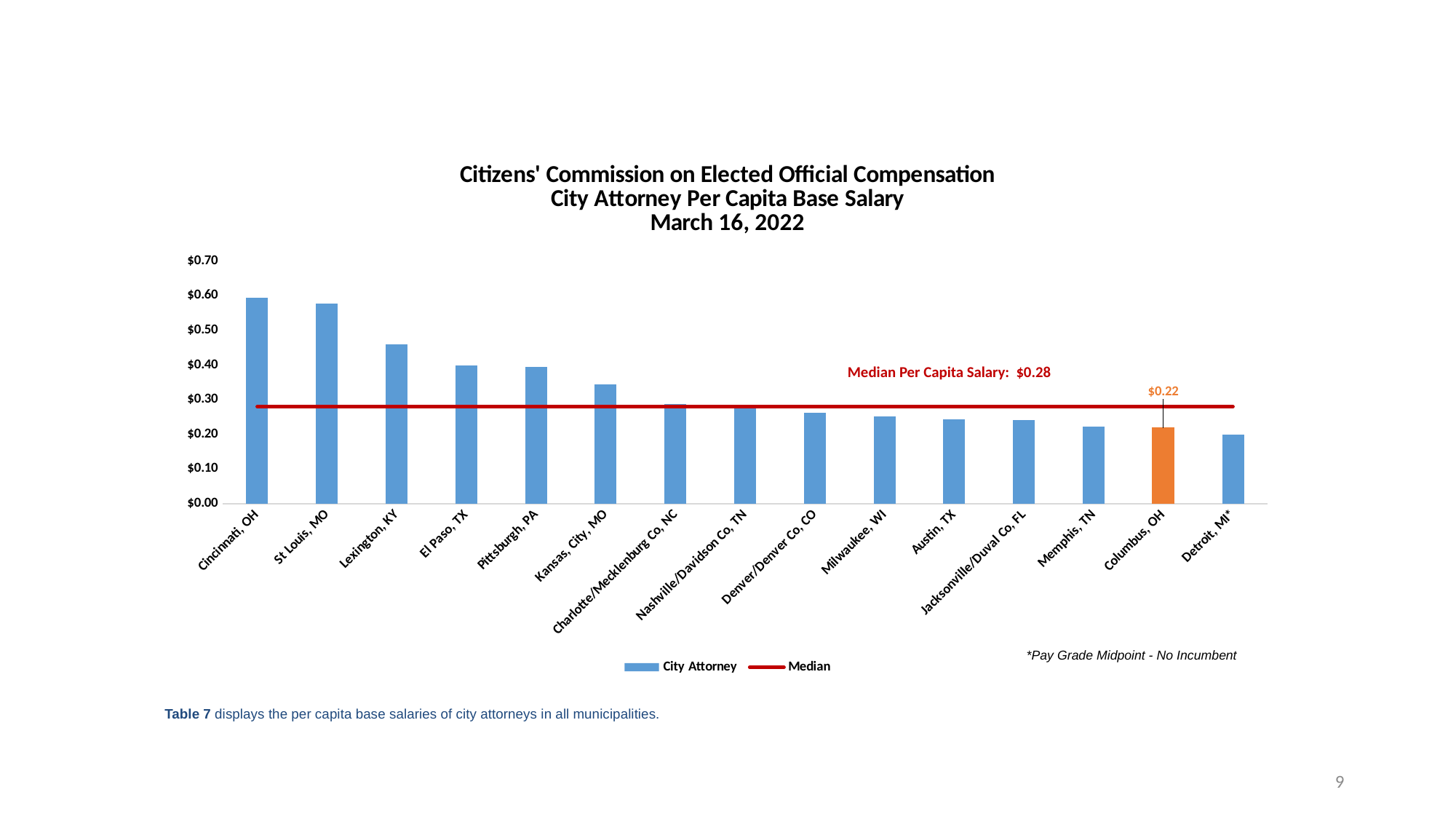
Is the value for Lexington, KY greater or less than $0.40? greater Which has a higher per capita base salary, Lexington, KY or El Paso, TX? Lexington, KY Do the bar values rise or fall from left to right across the chart? fall How many cities are shown on the chart? 15 Is the value for Kansas City, MO greater or less than $0.30? greater Is the value for Cincinnati, OH greater or less than $0.50? greater How many series does the legend list? 2 What is the per capita base salary shown for Columbus, OH? $0.22 Which has a higher per capita base salary, Pittsburgh, PA or Memphis, TN? Pittsburgh, PA Which city has the lowest city attorney per capita base salary? Detroit, MI* What is the median per capita salary shown on the chart? $0.28